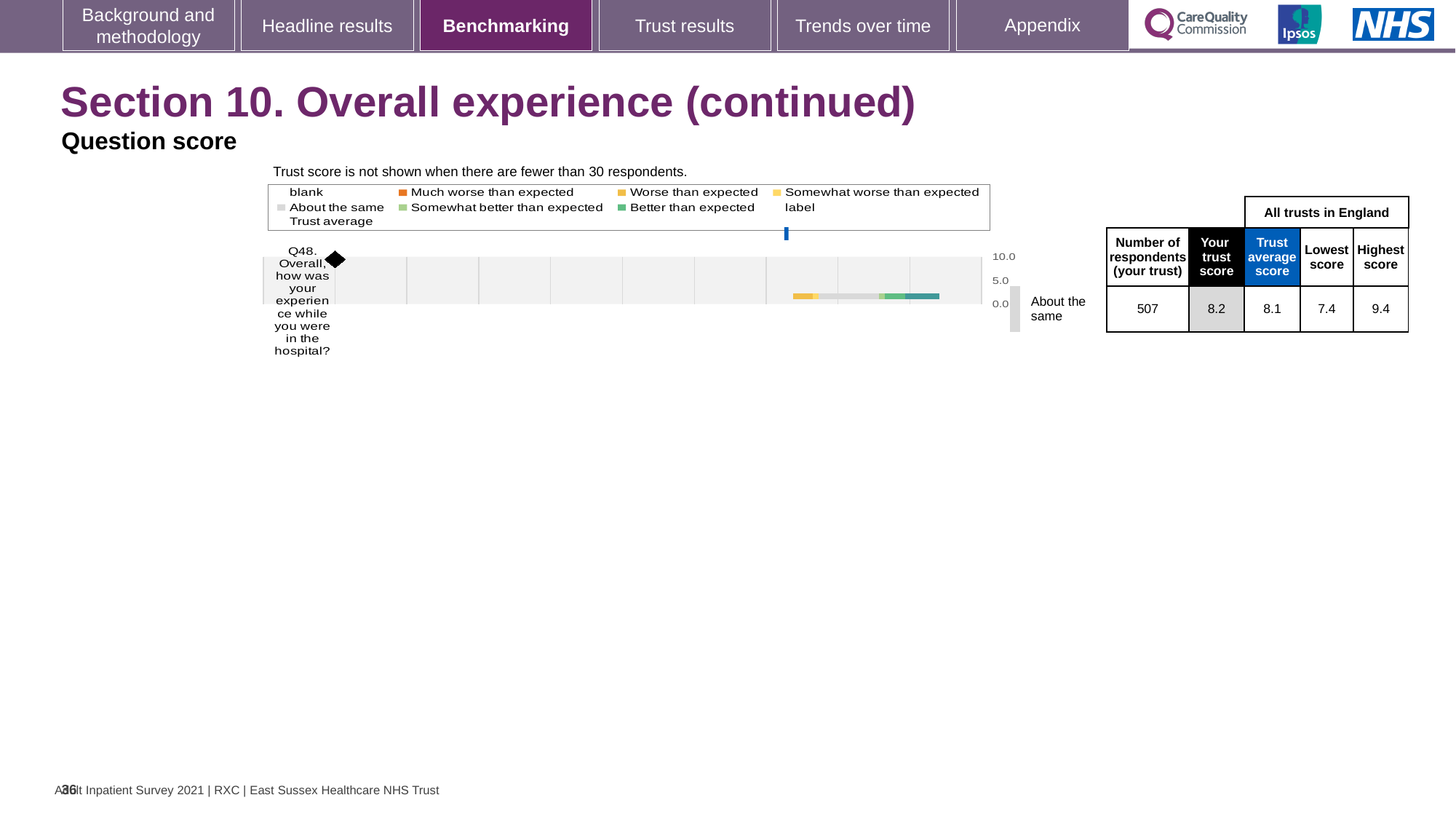
According to the table, what is your trust score for Q48? 8.2 What kind of chart is shown on the slide? bar chart What is the difference between the highest score and the lowest score for Q48 in the table? 2.0 According to the table, what is the number of respondents for your trust for Q48? 507 Which is larger for Q48, your trust score or the trust average score? Your trust score What benchmark category label is shown next to the chart for Q48? About the same Which question is plotted on the chart? Q48. Overall, how was your experience while you were in the hospital? According to the table, what is the lowest score among all trusts in England for Q48? 7.4 How many question categories are plotted on the chart? 1 According to the table, what is the trust average score for Q48? 8.1 According to the table, what is the highest score among all trusts in England for Q48? 9.4 What is the highest value shown on the chart's axis? 10.0